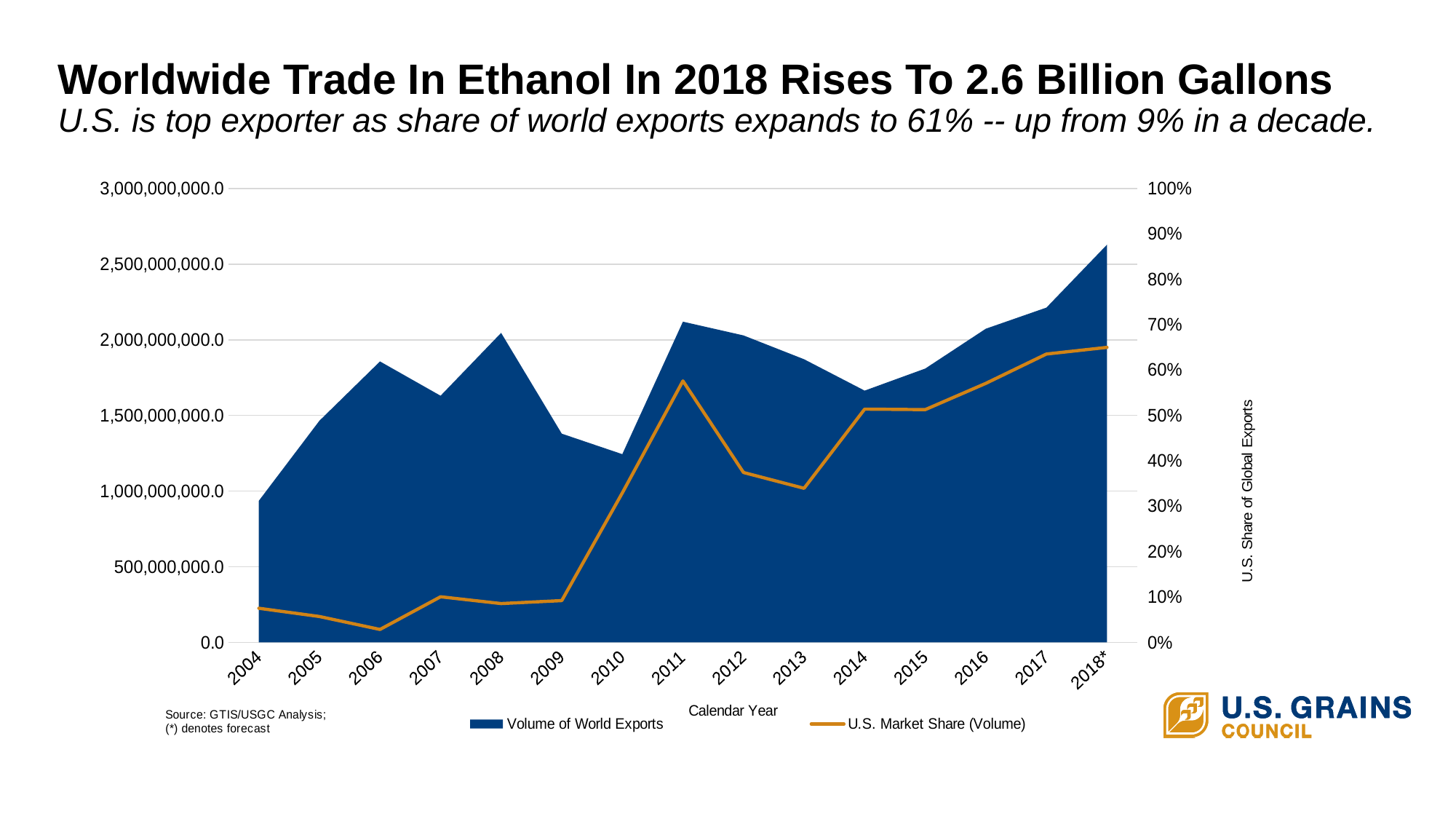
What kind of chart is shown on the slide? An area chart combined with a line chart Which year has the larger Volume of World Exports, 2009 or 2011? 2011 Which year has the highest Volume of World Exports? 2018* Which year has the lowest Volume of World Exports? 2004 Is the Volume of World Exports for 2004 greater or less than 1,000,000,000.0? less What is the label of the right-hand vertical axis? U.S. Share of Global Exports Is the Volume of World Exports for 2018* greater or less than 2,500,000,000.0? greater How many series does the legend list? 2 Is the U.S. Market Share (Volume) for 2011 greater or less than 50%? greater Which year has the lowest U.S. Market Share (Volume)? 2006 How many calendar years are plotted along the x axis? 15